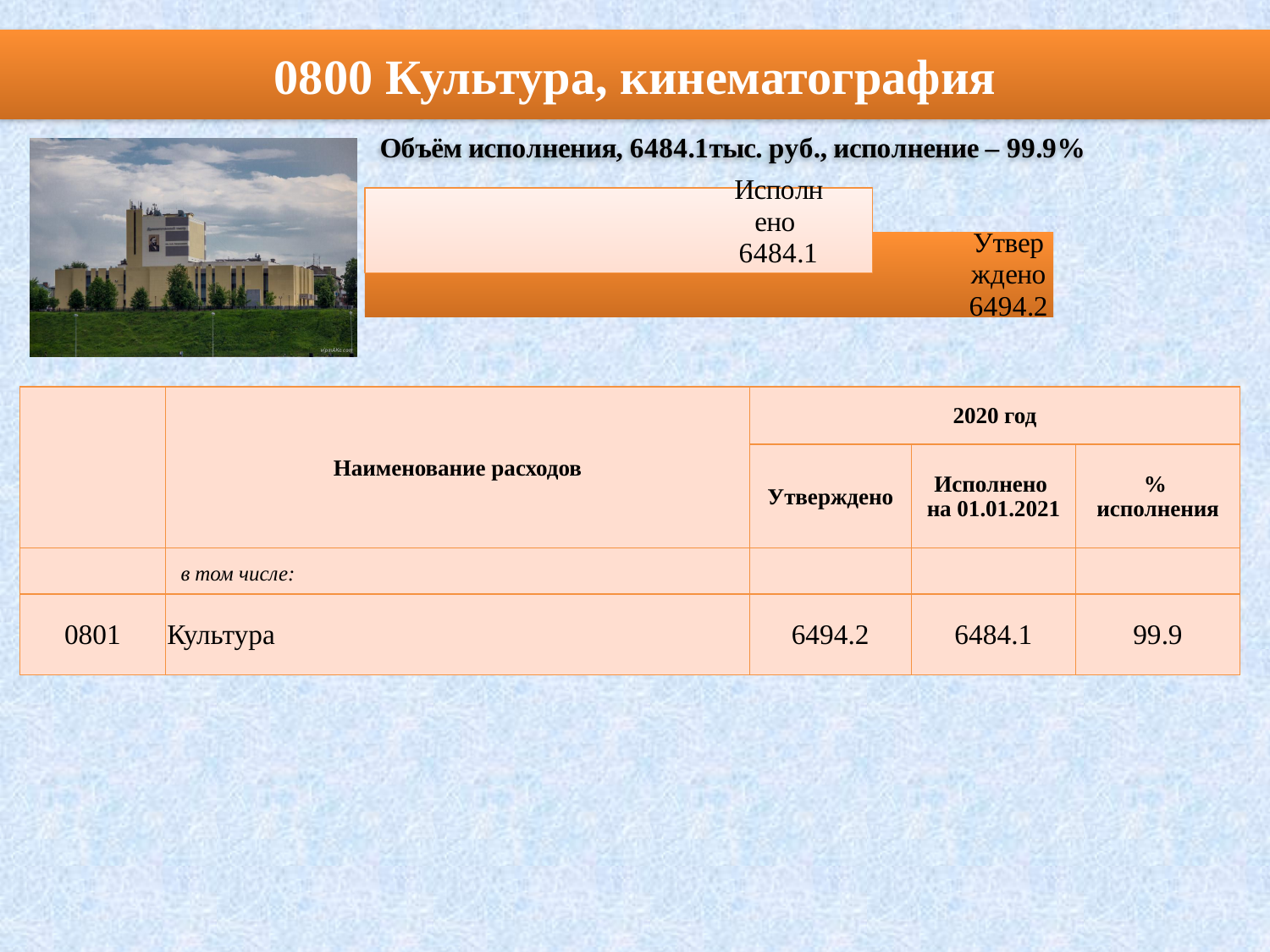
How many bars are plotted in the chart? 2 What kind of chart is shown on the slide? bar chart What are the labels of the two bars in the chart? Исполнено and Утверждено What is the value of the Исполнено bar? 6484.1 Which bar in the chart is drawn in dark orange? Утверждено What is the difference between the Утверждено and Исполнено values? 10.1 Which category has the highest value in the chart? Утверждено Which bar has the higher value, Исполнено or Утверждено? Утверждено Which category has the lowest value in the chart? Исполнено What is the value of the Утверждено bar? 6494.2